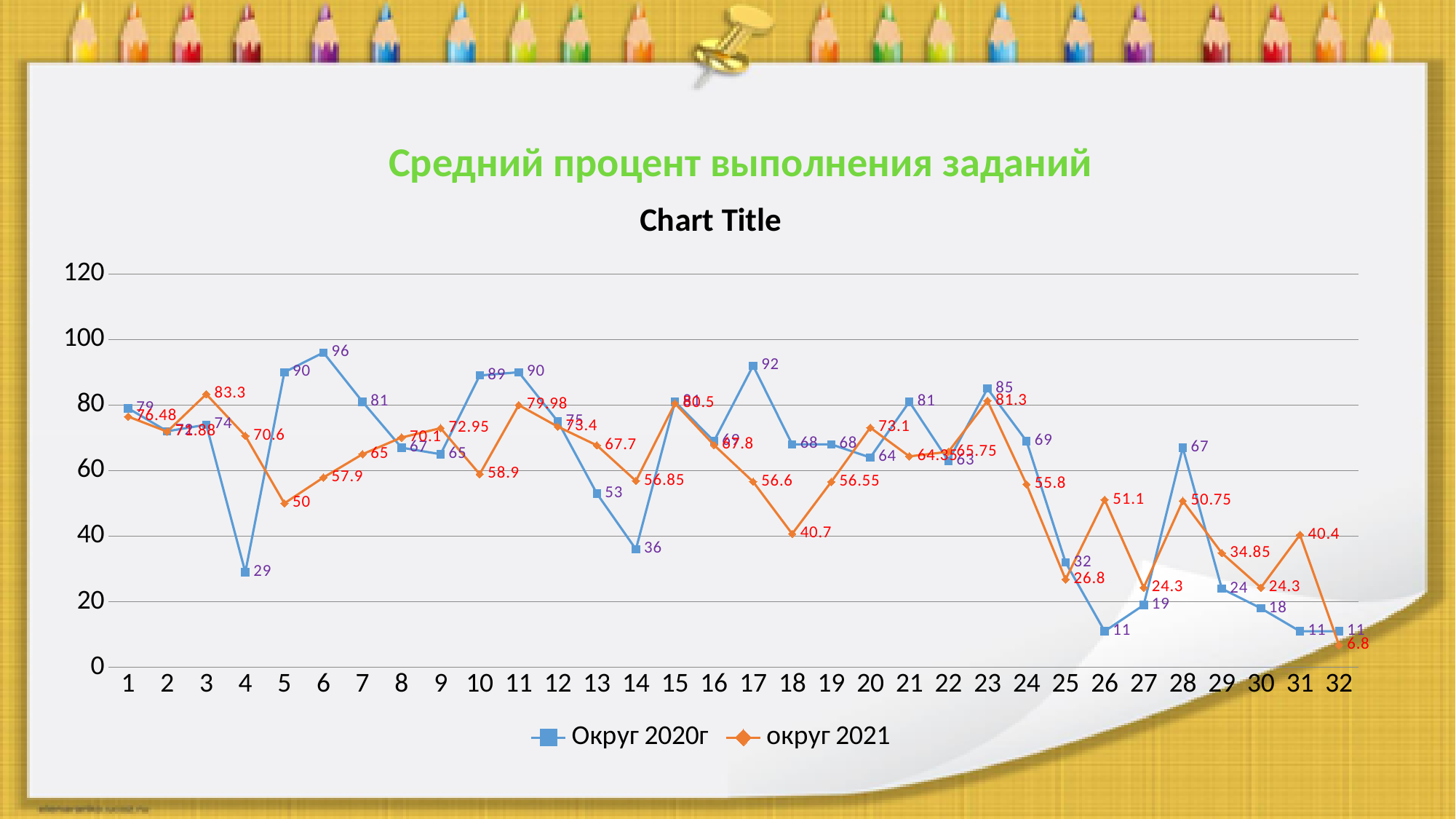
What is the difference between Округ 2020г and округ 2021 at point 4? 41.6 At point 26, which series has the larger value, Округ 2020г or округ 2021? округ 2021 How many points are plotted along the x axis for each series? 32 What type of chart is shown on the slide? line chart How many series does the legend list? 2 What is the value of округ 2021 at point 32? 6.8 At which x-axis point does Округ 2020г reach its highest value? 6 At which x-axis point does округ 2021 reach its lowest value? 32 At which x-axis point does округ 2021 reach its highest value? 3 What is the green heading above the chart? Средний процент выполнения заданий What is the value of округ 2021 at point 18? 40.7 What is the value of Округ 2020г at point 6? 96